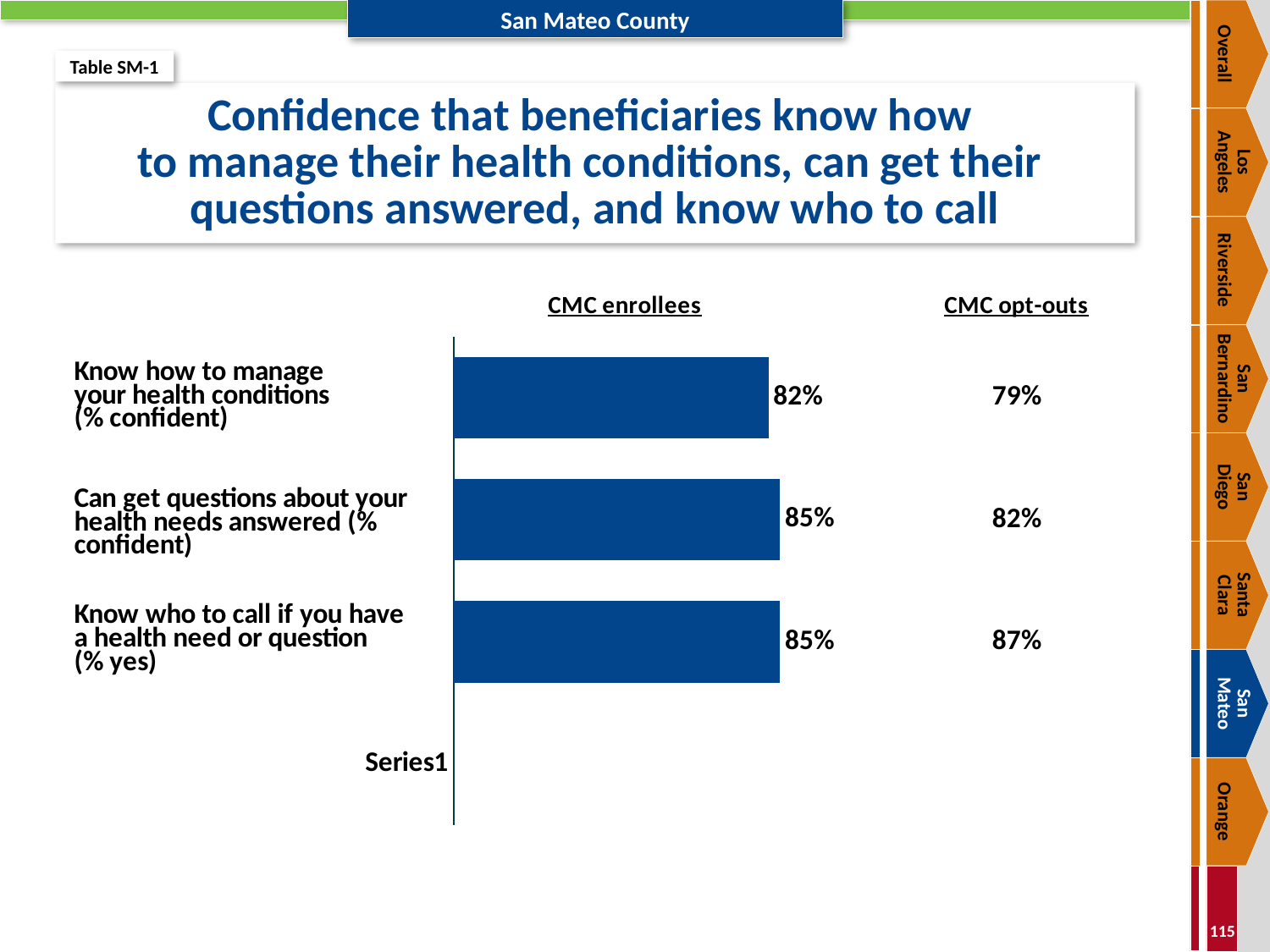
For "Know who to call if you have a health need or question (% yes)", which is larger: the CMC enrollees value or the CMC opt-outs value? CMC opt-outs What is the table label shown at the top left of the slide? Table SM-1 What is the CMC enrollees value for "Can get questions about your health needs answered (% confident)"? 85% How many categories (questions) are plotted in the chart? 3 What is the CMC opt-outs value for "Know how to manage your health conditions (% confident)"? 79% What is the CMC enrollees value for "Know how to manage your health conditions (% confident)"? 82% What is the difference between the CMC enrollees and CMC opt-outs values for "Know how to manage your health conditions (% confident)"? 3% Which is larger for CMC enrollees: "Know how to manage your health conditions" or "Can get questions about your health needs answered"? Can get questions about your health needs answered What is the CMC enrollees value for "Know who to call if you have a health need or question (% yes)"? 85% Which category has the lowest CMC enrollees value? Know how to manage your health conditions (% confident) What kind of chart is shown on the slide? bar chart What is the CMC opt-outs value for "Know who to call if you have a health need or question (% yes)"? 87%